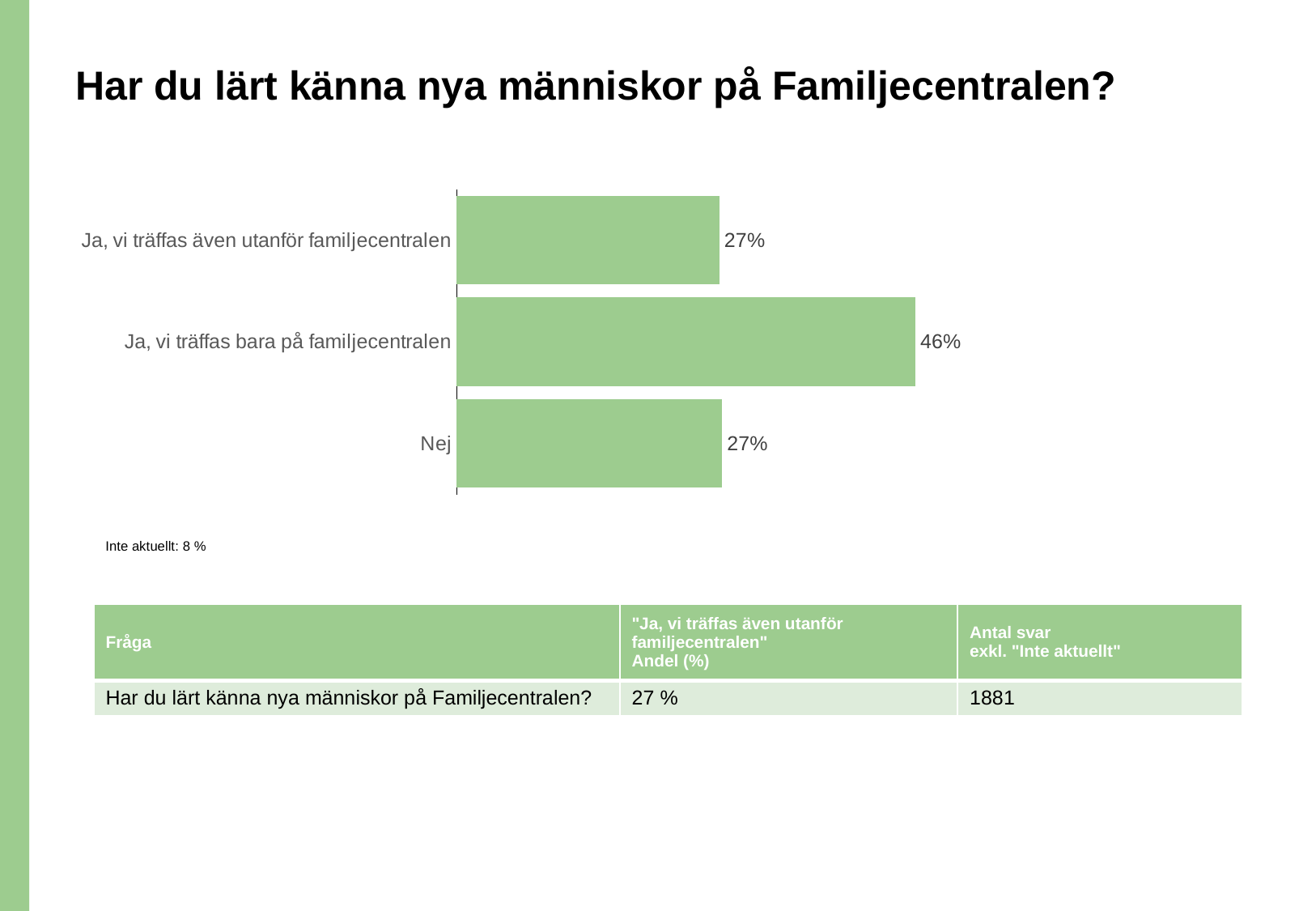
What is the title of the slide? Har du lärt känna nya människor på Familjecentralen? What is the difference between "Ja, vi träffas bara på familjecentralen" and "Nej"? 19% Which is larger: "Ja, vi träffas bara på familjecentralen" or "Ja, vi träffas även utanför familjecentralen"? Ja, vi träffas bara på familjecentralen What is the total of the three plotted values? 100% How many categories are shown in the chart? 3 What is the value for "Nej"? 27% What percentage is given for "Inte aktuellt" below the chart? 8 % Which category has the highest value? Ja, vi träffas bara på familjecentralen What is the value for "Ja, vi träffas bara på familjecentralen"? 46% What kind of chart is shown on the slide? Bar chart What is the value for "Ja, vi träffas även utanför familjecentralen"? 27%